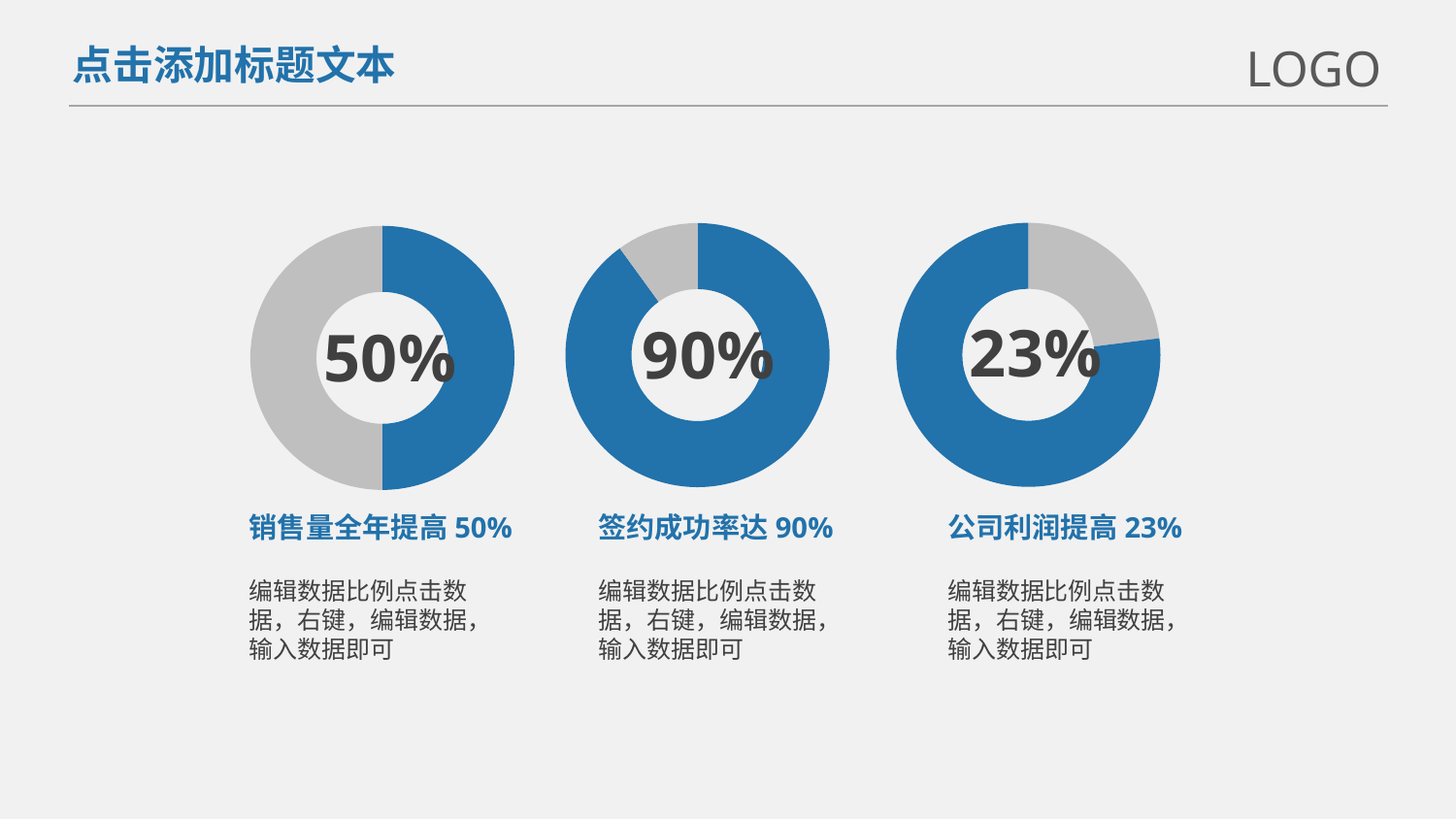
What percentage is shown in the centre of the middle donut chart? 90% What percentage is shown in the centre of the left donut chart? 50% How many donut charts are on the slide? 3 What is the difference between the percentage in the left chart and the percentage in the right chart? 27 percentage points What is the caption printed below the left donut chart? 销售量全年提高 50% What colour is used for the highlighted segment in each donut chart? Blue What kind of charts are shown on the slide? Donut (pie) charts What is the difference between the percentage in the middle chart and the percentage in the left chart? 40 percentage points What percentage is shown in the centre of the right donut chart? 23% Which of the three donut charts shows the lowest percentage? The right chart (公司利润提高 23%) Which is larger, the percentage in the middle chart or the percentage in the right chart? The middle chart (90%) Which of the three donut charts shows the highest percentage? The middle chart (签约成功率达 90%)